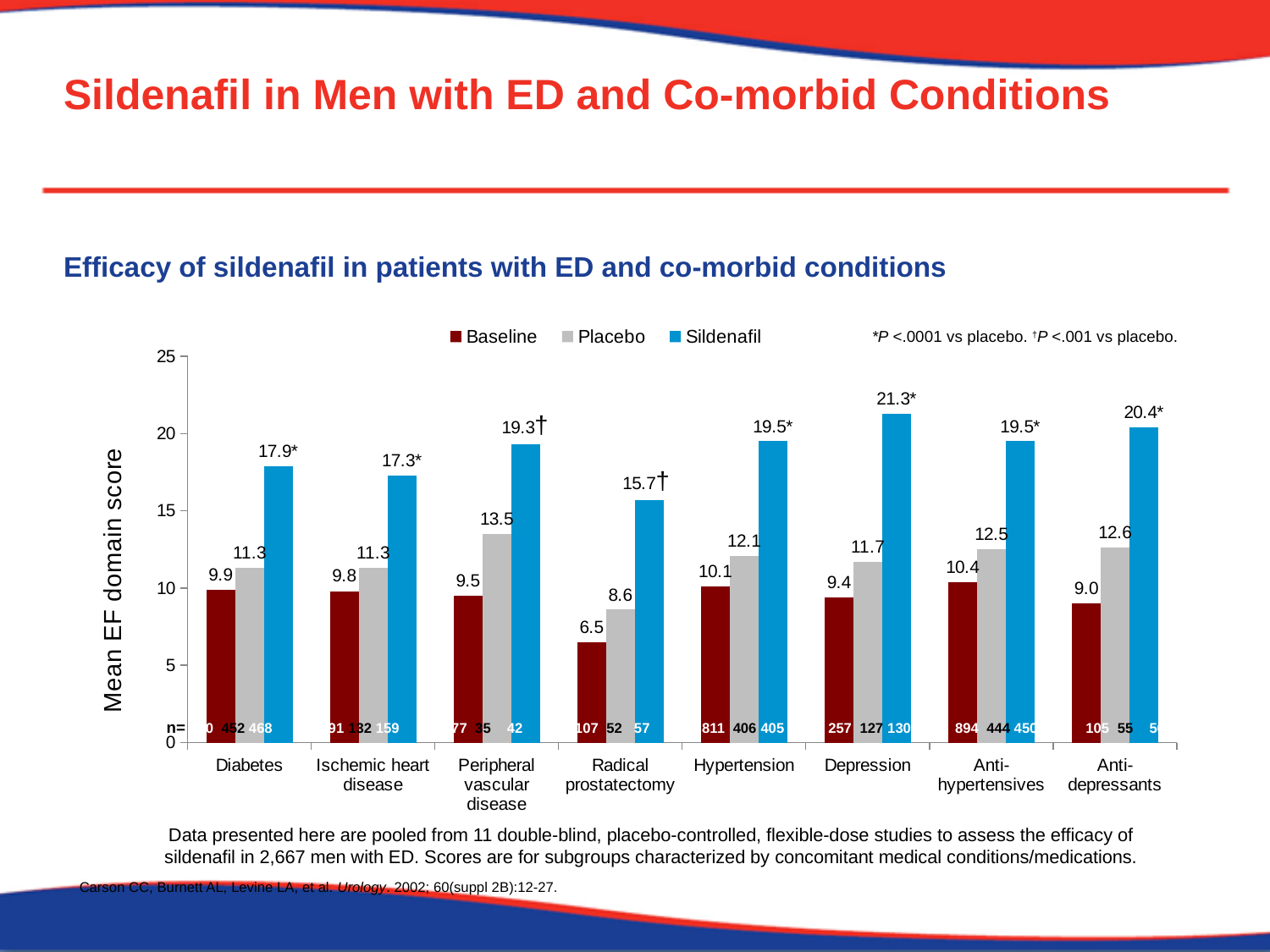
Which condition has the highest Sildenafil mean EF domain score? Depression What kind of chart is shown on the slide? Bar chart What is the Placebo mean EF domain score for Depression? 11.7 What is the title of the y axis? Mean EF domain score What is the Baseline mean EF domain score for Diabetes? 9.9 Which is larger: the Placebo score for Diabetes or the Placebo score for Anti-depressants? Anti-depressants How many series does the legend list? 3 Which condition has the lowest Baseline mean EF domain score? Radical prostatectomy For Hypertension, what is the difference between the Placebo score and the Baseline score? 2.0 How many co-morbid condition categories are shown on the x axis? 8 What is the Placebo mean EF domain score for Peripheral vascular disease? 13.5 What is the Baseline mean EF domain score for Radical prostatectomy? 6.5